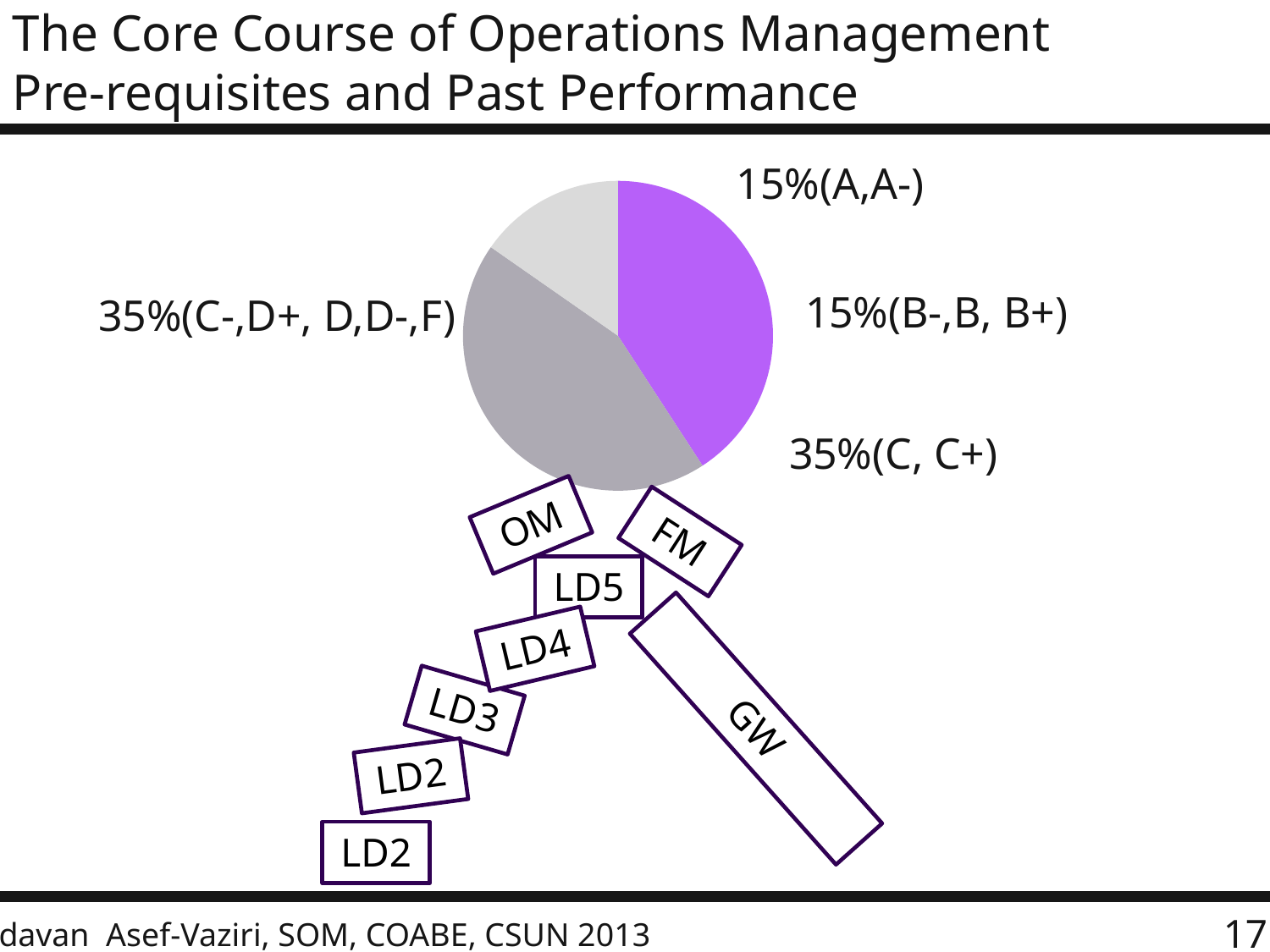
What percentage is shown for the (B-, B, B+) grade group? 15% What is the combined percentage of the (A, A-) and (B-, B, B+) groups? 30% What percentage is shown for the (C-, D+, D, D-, F) grade group? 35% What percentage is shown for the (C, C+) grade group? 35% What percentage of students received A or A- according to the pie chart? 15% What is the title of the slide containing the pie chart? The Core Course of Operations Management Pre-requisites and Past Performance What kind of chart is shown on the slide? pie chart Which is larger, the share for (C, C+) or the share for (A, A-)? (C, C+) What is the difference in percentage points between the (C, C+) group and the (A, A-) group? 20 What is the combined percentage of the two 35% groups, (C, C+) and (C-, D+, D, D-, F)? 70% How many grade groups are labelled on the pie chart? 4 Which is larger, the share for (B-, B, B+) or the share for (C-, D+, D, D-, F)? (C-, D+, D, D-, F)